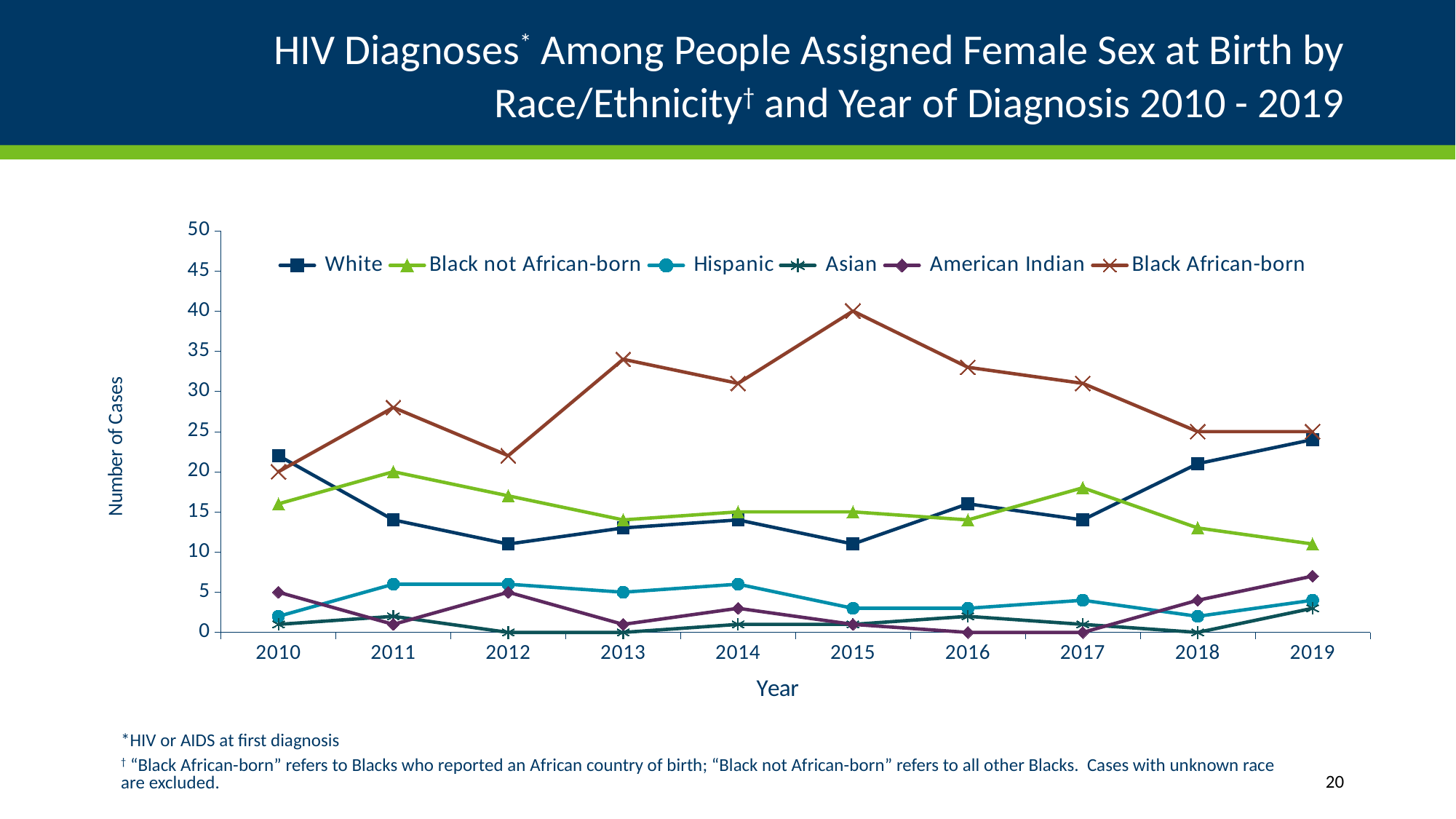
In 2019, which is larger: the value for White or the value for Black not African-born? White Does the Black not African-born series rise or fall from 2017 to 2019? fall What is the value for Black African-born in 2015? 40 What is the label on the y axis? Number of Cases How many series does the legend list? 6 What kind of chart is shown on the slide? line chart Is the value for White in 2019 greater or less than 20? greater Is the value for Hispanic in 2011 greater or less than 10? less In which year does the Black African-born series reach its highest value? 2015 What is the value for Asian in 2012? 0 What is the value for Black not African-born in 2011? 20 How many years are plotted along the x axis? 10